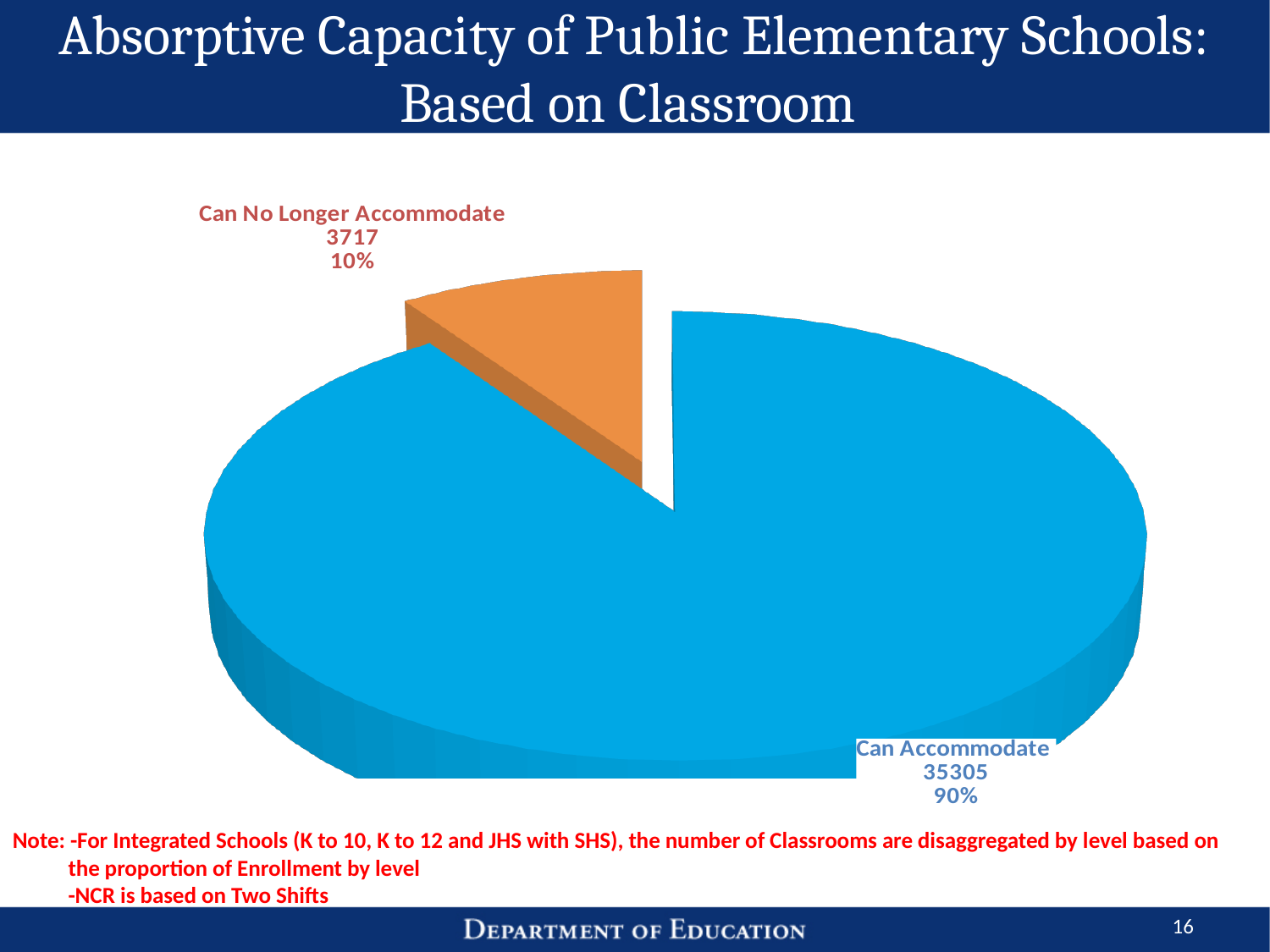
Which is larger, Can Accommodate or Can No Longer Accommodate? Can Accommodate What kind of chart is shown on the slide? Pie chart Which category has the smallest slice? Can No Longer Accommodate How many slices does the pie chart have? 2 What share of the pie does Can Accommodate represent? 90% What is the difference between the values for Can Accommodate and Can No Longer Accommodate? 31588 What share of the pie does Can No Longer Accommodate represent? 10% What is the total of the two slices in the pie chart? 39022 What is the value for Can No Longer Accommodate? 3717 What colour is the Can No Longer Accommodate slice? Orange What is the value for Can Accommodate? 35305 Which category has the largest slice? Can Accommodate